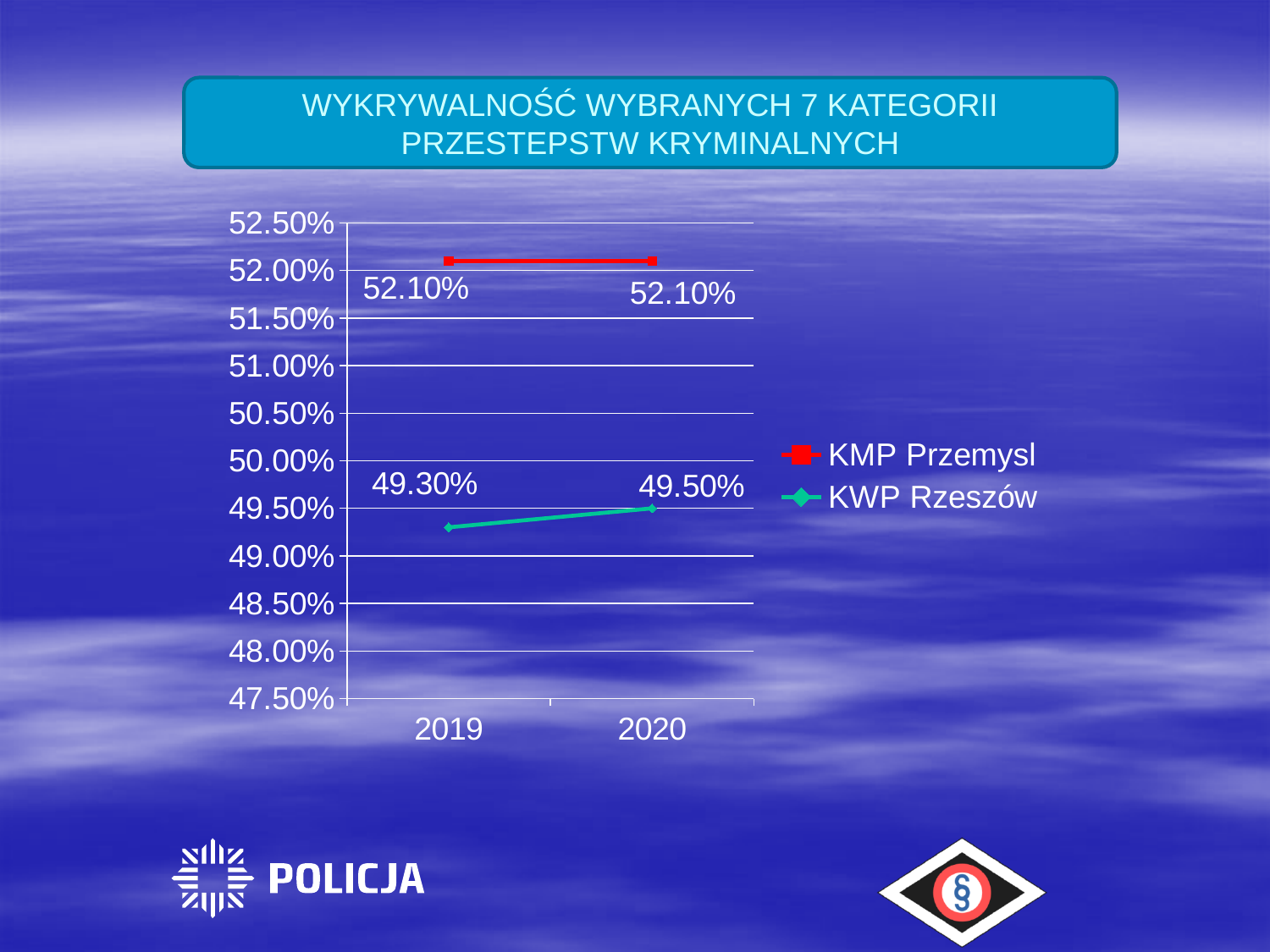
What is the value for KWP Rzeszów in 2020? 49.50% What is the value for KWP Rzeszów in 2019? 49.30% By how much did the KWP Rzeszów value change from 2019 to 2020? 0.20% What is the value for KMP Przemysl in 2019? 52.10% How many years are shown on the x axis? 2 What kind of chart is shown on the slide? line chart Does the KMP Przemysl line rise, fall or stay flat from 2019 to 2020? stay flat What is the difference between the KMP Przemysl and KWP Rzeszów values in 2019? 2.80% How many series does the legend list? 2 Which series has the higher value in 2020, KMP Przemysl or KWP Rzeszów? KMP Przemysl Does the KWP Rzeszów line rise, fall or stay flat from 2019 to 2020? rise Which colour is used for the KWP Rzeszów line? green